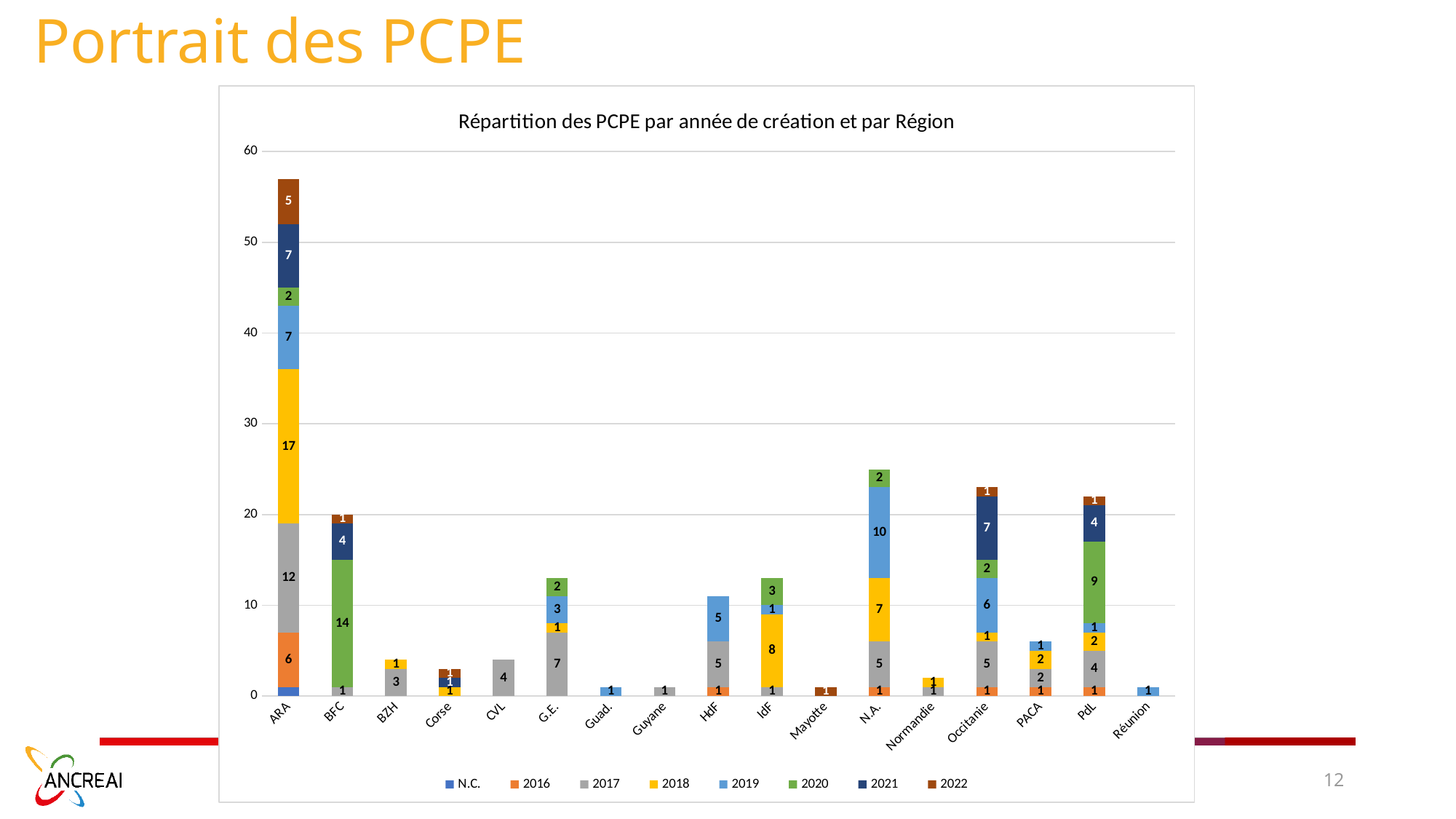
What is the difference between the 2020 segment for BFC and the 2020 segment for PdL? 5 What type of chart is shown on the slide? Stacked bar chart What is the total of the stacked bar for N.A.? 25 How many series does the legend list? 8 What is the title of the chart? Répartition des PCPE par année de création et par Région What is the value of the 2018 segment for ARA? 17 Which region has the tallest stacked bar overall? ARA What is the total of the stacked bar for BFC? 20 Which is larger, the 2021 segment for Occitanie or the 2021 segment for PdL? Occitanie What is the value of the 2020 segment for BFC? 14 How many regions are shown on the x axis? 17 What is the value of the 2019 segment for N.A.? 10